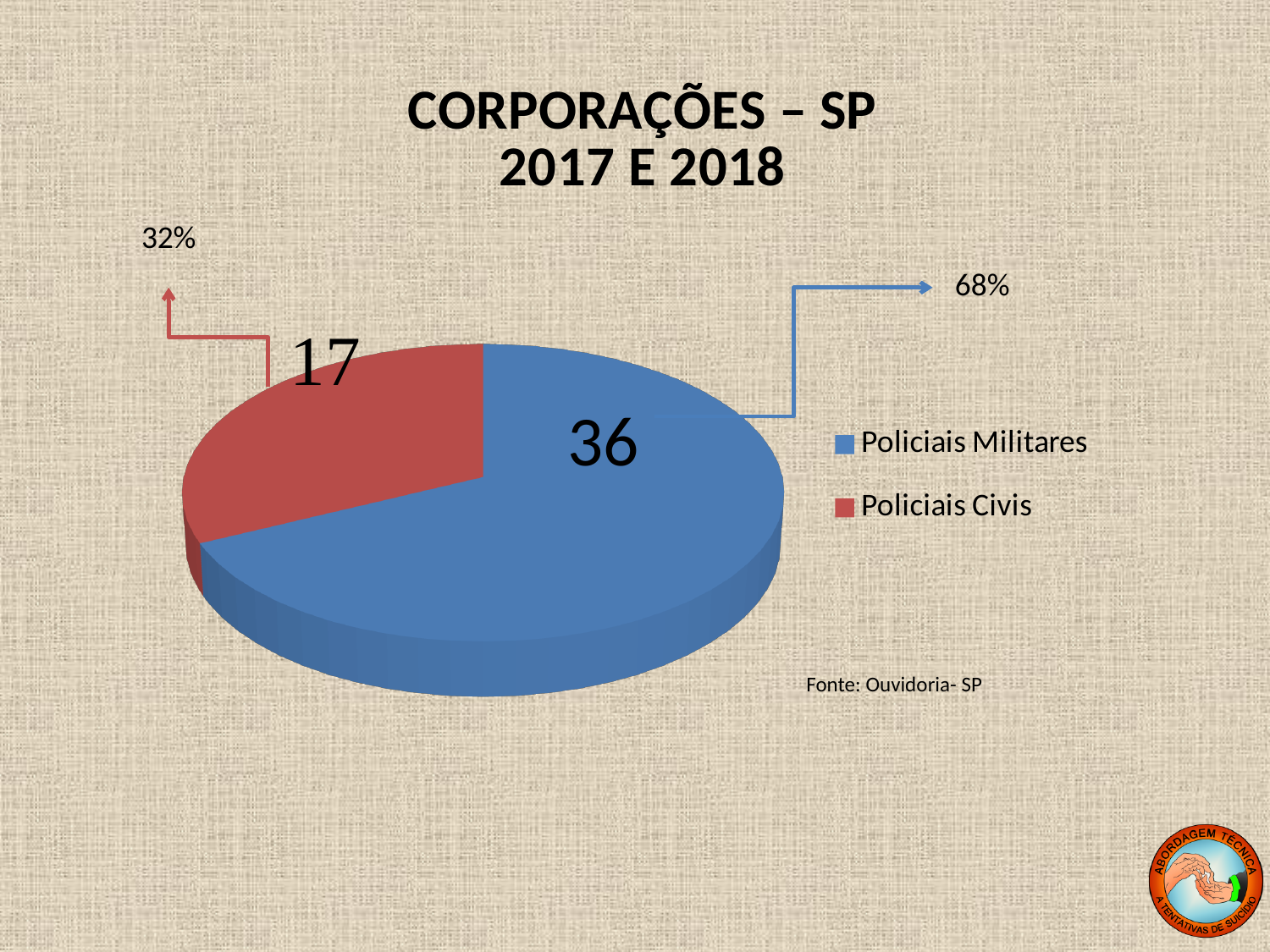
What is the difference between the values for Policiais Militares and Policiais Civis? 19 What percentage share of the pie does Policiais Civis represent, as labelled on the slide? 32% How many categories does the pie chart show? 2 What kind of chart is shown on the slide? Pie chart What is the title of the chart? CORPORAÇÕES – SP 2017 E 2018 Which category has the largest slice of the pie? Policiais Militares Which is larger, the value for Policiais Militares or the value for Policiais Civis? Policiais Militares Which category has the smallest slice of the pie? Policiais Civis What is the total of the two slices in the pie chart? 53 What is the value for Policiais Militares? 36 What percentage share of the pie does Policiais Militares represent, as labelled on the slide? 68% What is the value for Policiais Civis? 17